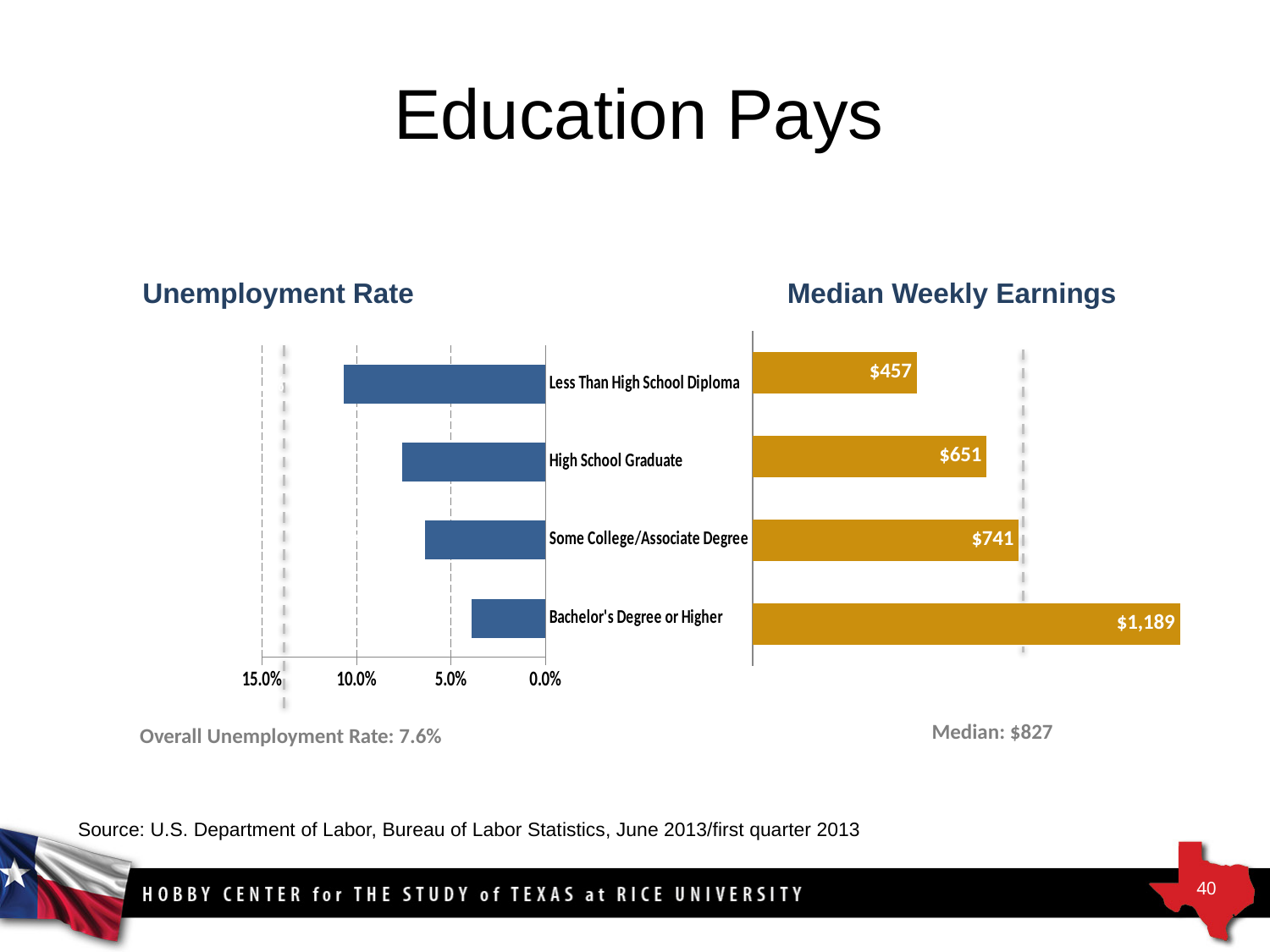
In the Median Weekly Earnings chart, what is the difference between Bachelor's Degree or Higher and Less Than High School Diploma? $732 In the Median Weekly Earnings chart, which education level has the highest median weekly earnings? Bachelor's Degree or Higher What type of chart is the Median Weekly Earnings chart? Bar chart In the Median Weekly Earnings chart, what is the difference between Some College/Associate Degree and High School Graduate? $90 In the Median Weekly Earnings chart, what is the value for Less Than High School Diploma? $457 In the Median Weekly Earnings chart, which education level has the lowest median weekly earnings? Less Than High School Diploma In the Median Weekly Earnings chart, what is the median weekly earnings for High School Graduate? $651 In the Unemployment Rate chart, is the value for Bachelor's Degree or Higher greater or less than 5.0%? less In the Median Weekly Earnings chart, what is the value for Bachelor's Degree or Higher? $1,189 In the Unemployment Rate chart, is the value for High School Graduate greater or less than 5.0%? greater How many education categories are shown in the Unemployment Rate chart? 4 In the Unemployment Rate chart, which education level has the highest unemployment rate? Less Than High School Diploma